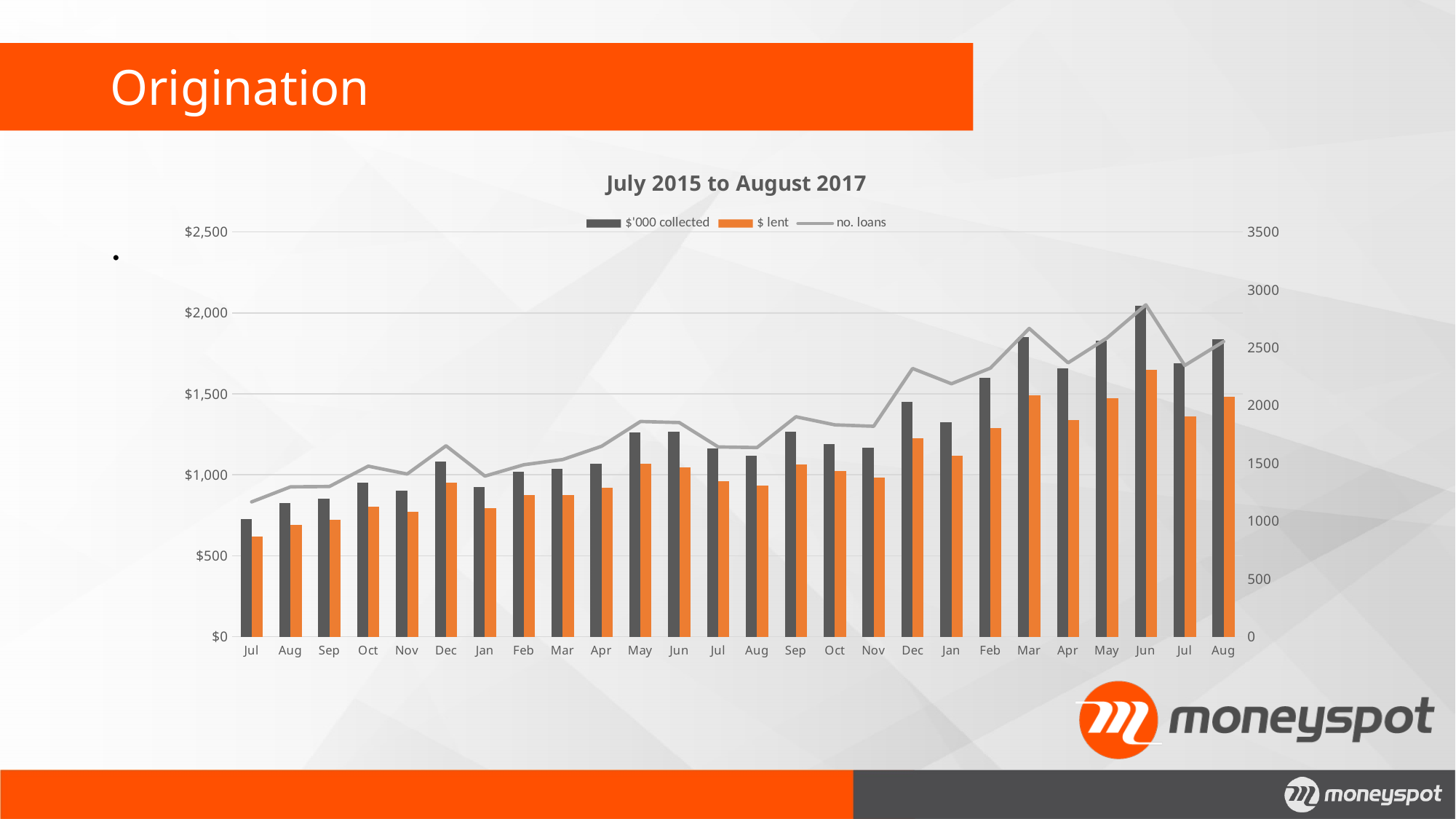
Which is larger, the $'000 collected bar for Mar 2017 or for Apr 2017? Mar 2017 Is the $ lent value for Aug 2017 greater or less than $1,000? greater Is the $'000 collected value for Jul 2015 greater or less than $1,000? less What is the title of the chart? July 2015 to August 2017 How many months are plotted along the x axis? 26 Which month has the highest $ lent bar? Jun 2017 Which month has the highest $'000 collected bar? Jun 2017 Is the $'000 collected value for Jun 2017 greater or less than $1,500? greater How many series does the chart legend list? 3 Which month has the lowest $'000 collected bar? Jul 2015 Do the $'000 collected values generally rise or fall from July 2015 to August 2017? rise What kind of chart is this? Bar chart with a line